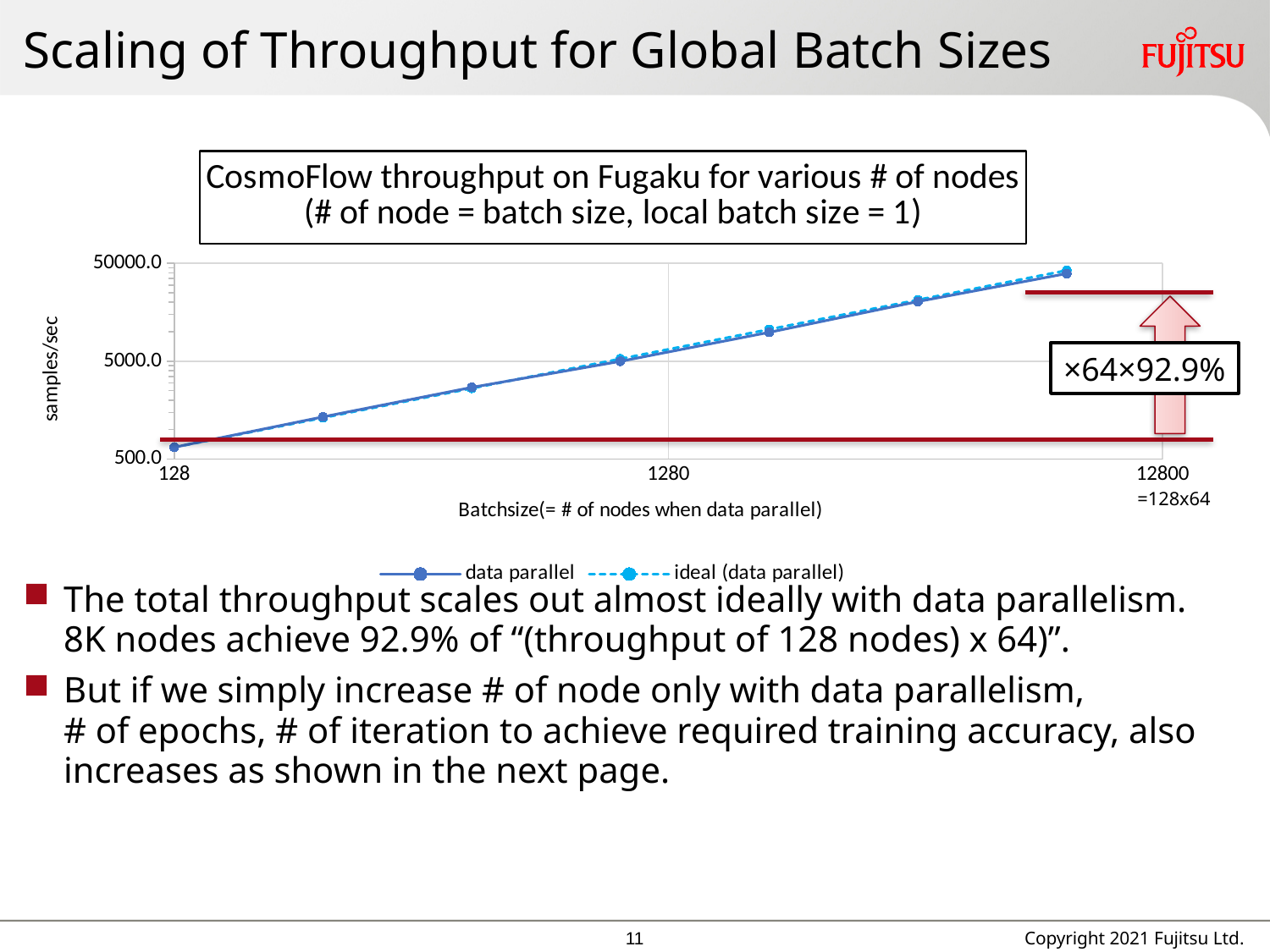
How many series does the chart's legend list? 2 Is the data parallel throughput at the largest plotted batch size greater or less than 50000.0 samples/sec? less Do the throughput values rise or fall as the batch size increases along the x axis? rise What are the two series named in the chart's legend? data parallel; ideal (data parallel) What is the smallest batch size shown on the x axis? 128 What kind of chart is shown on the slide? line chart What is the largest batch size shown on the x axis? 12800 What is the label of the y axis? samples/sec How many data points are plotted for the data parallel series? 7 Is the data parallel throughput at batch size 128 greater or less than 5000.0 samples/sec? less What is the title of the chart? CosmoFlow throughput on Fugaku for various # of nodes (# of node = batch size, local batch size = 1) Is the data parallel throughput at the largest plotted batch size greater or less than 5000.0 samples/sec? greater